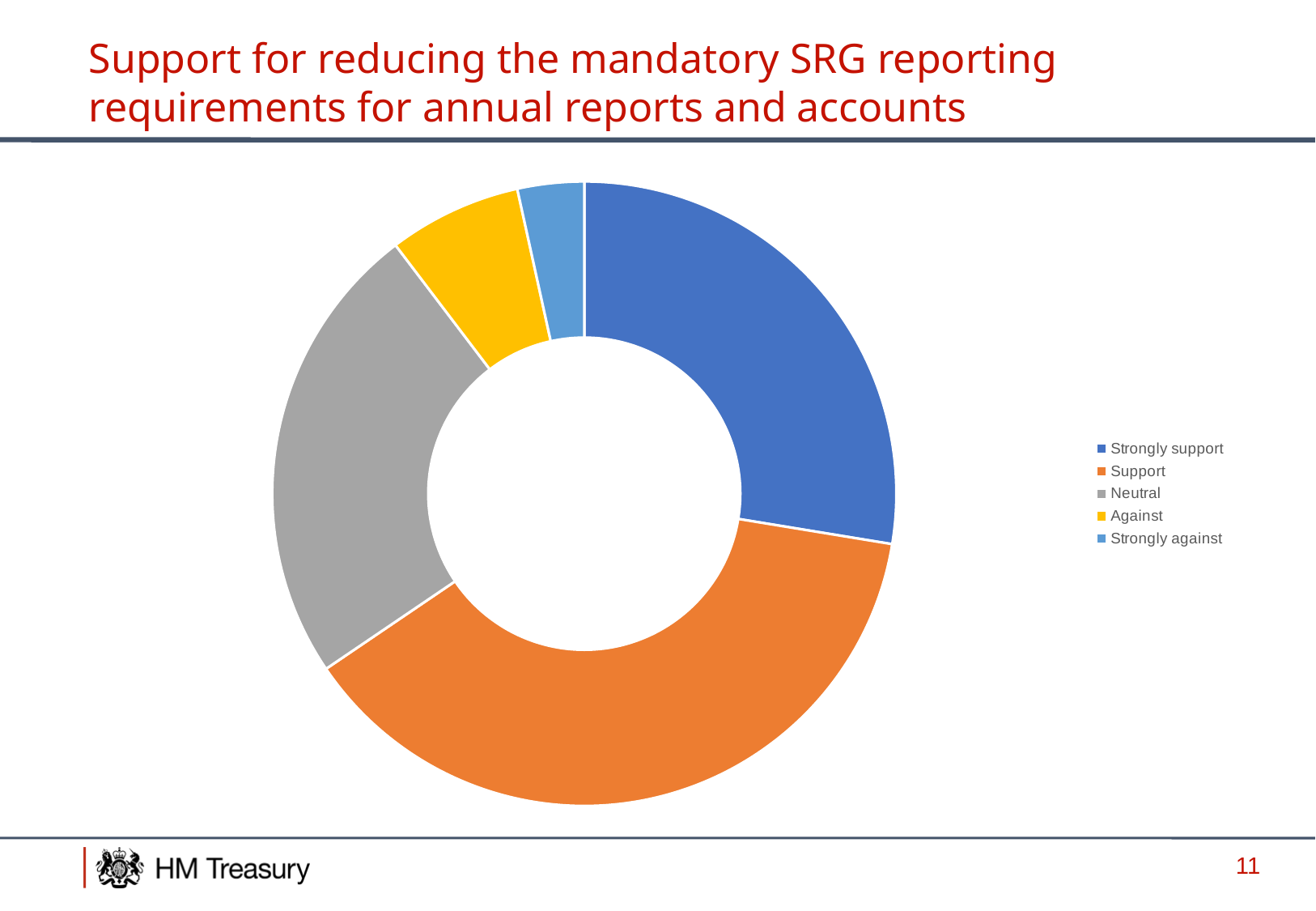
Which category is shown in orange in the chart? Support What is the title of the slide containing the chart? Support for reducing the mandatory SRG reporting requirements for annual reports and accounts Which slice is larger, Support or Strongly support? Support How many categories does the legend of the chart list? 5 What kind of chart is shown on the slide? doughnut chart Which category has the largest slice in the chart? Support Which slice is larger, Against or Strongly against? Against Which slice is larger, Neutral or Against? Neutral Which category has the smallest slice in the chart? Strongly against